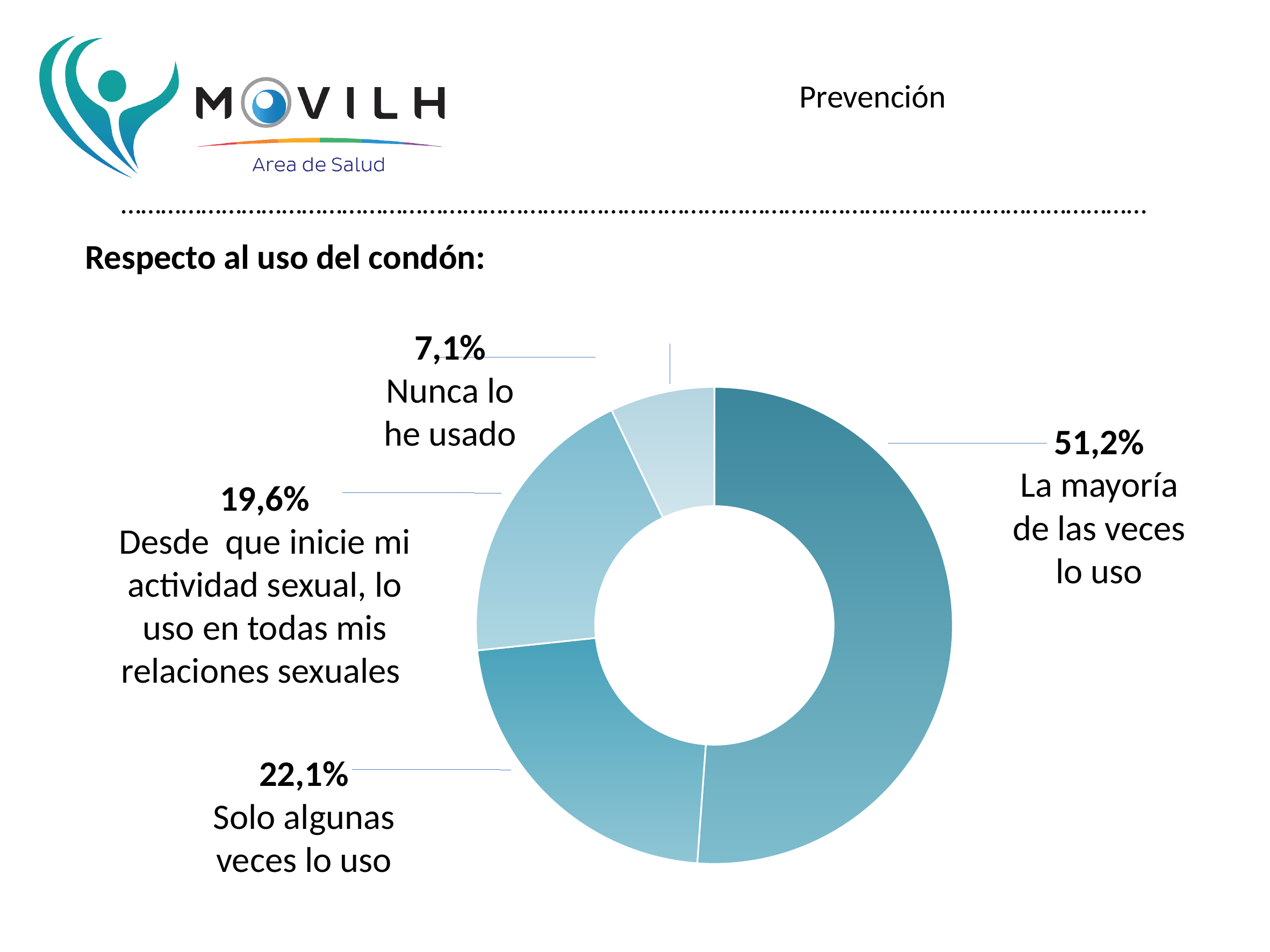
What percentage of respondents answered "Nunca lo he usado"? 7,1% What percentage of respondents answered "La mayoría de las veces lo uso"? 51,2% Which response has the largest share of the chart? La mayoría de las veces lo uso What is the heading above the chart? Respecto al uso del condón: What is the difference in percentage points between "La mayoría de las veces lo uso" and "Solo algunas veces lo uso"? 29,1 Which is larger: the share for "Solo algunas veces lo uso" or the share for "Desde que inicie mi actividad sexual, lo uso en todas mis relaciones sexuales"? Solo algunas veces lo uso What percentage of respondents answered "Desde que inicie mi actividad sexual, lo uso en todas mis relaciones sexuales"? 19,6% Which response has the smallest share of the chart? Nunca lo he usado What is the difference in percentage points between "Solo algunas veces lo uso" and "Nunca lo he usado"? 15 How many response categories are shown in the chart? 4 What kind of chart is shown on the slide? Doughnut (pie) chart What percentage of respondents answered "Solo algunas veces lo uso"? 22,1%